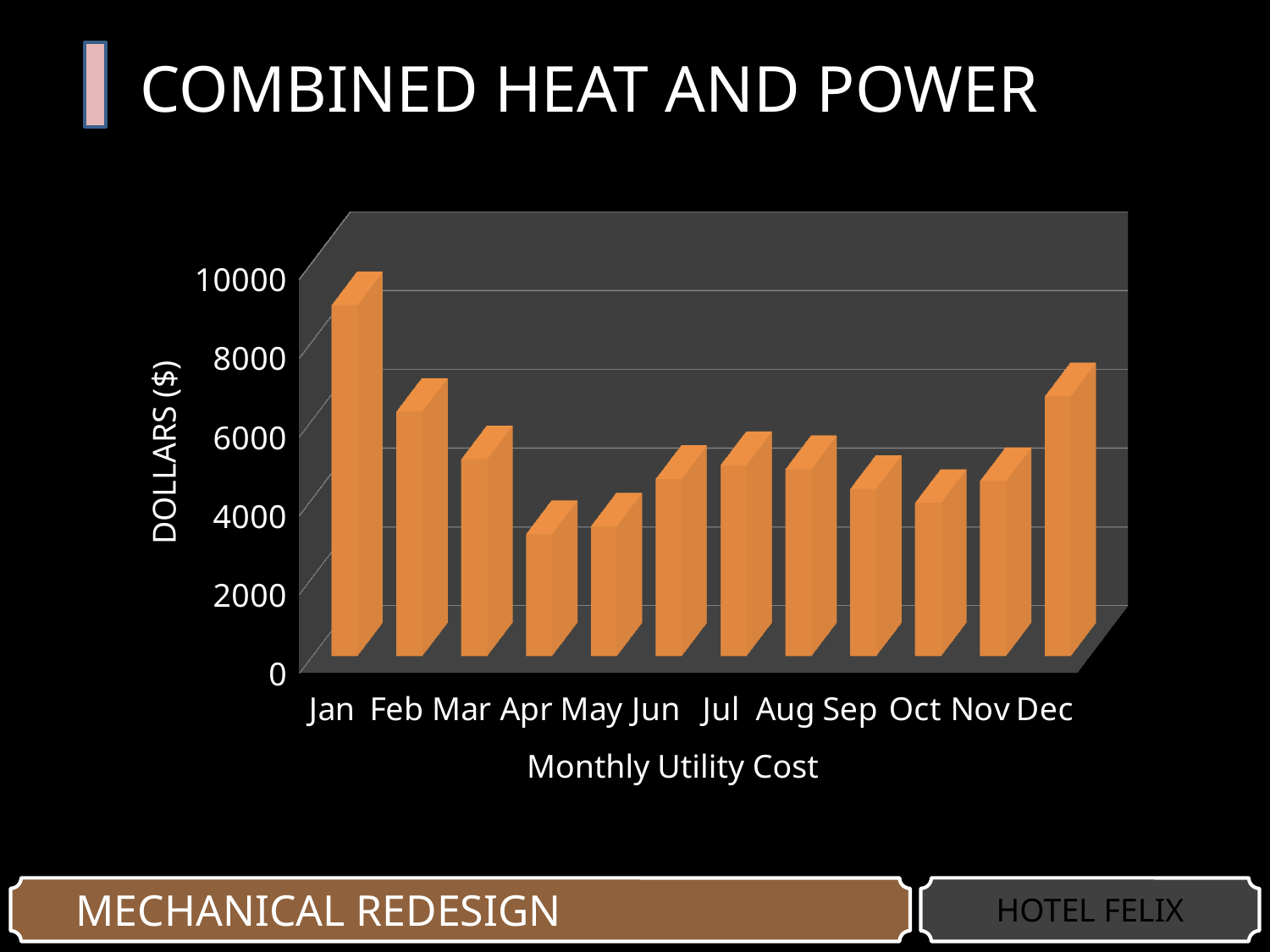
What is the label on the vertical axis of the chart? DOLLARS ($) Is the value for Dec greater or less than 6000? greater Which month has the highest monthly utility cost? Jan Do the values rise or fall from Jan to Apr? fall Which month has a higher utility cost, Feb or Mar? Feb Which month has the lowest monthly utility cost? Apr Is the value for Apr greater or less than 4000? less What kind of chart is shown on the slide? bar chart Which month has a higher utility cost, Jan or Dec? Jan How many months are plotted on the x axis of the chart? 12 Is the value for Jan greater or less than 8000? greater